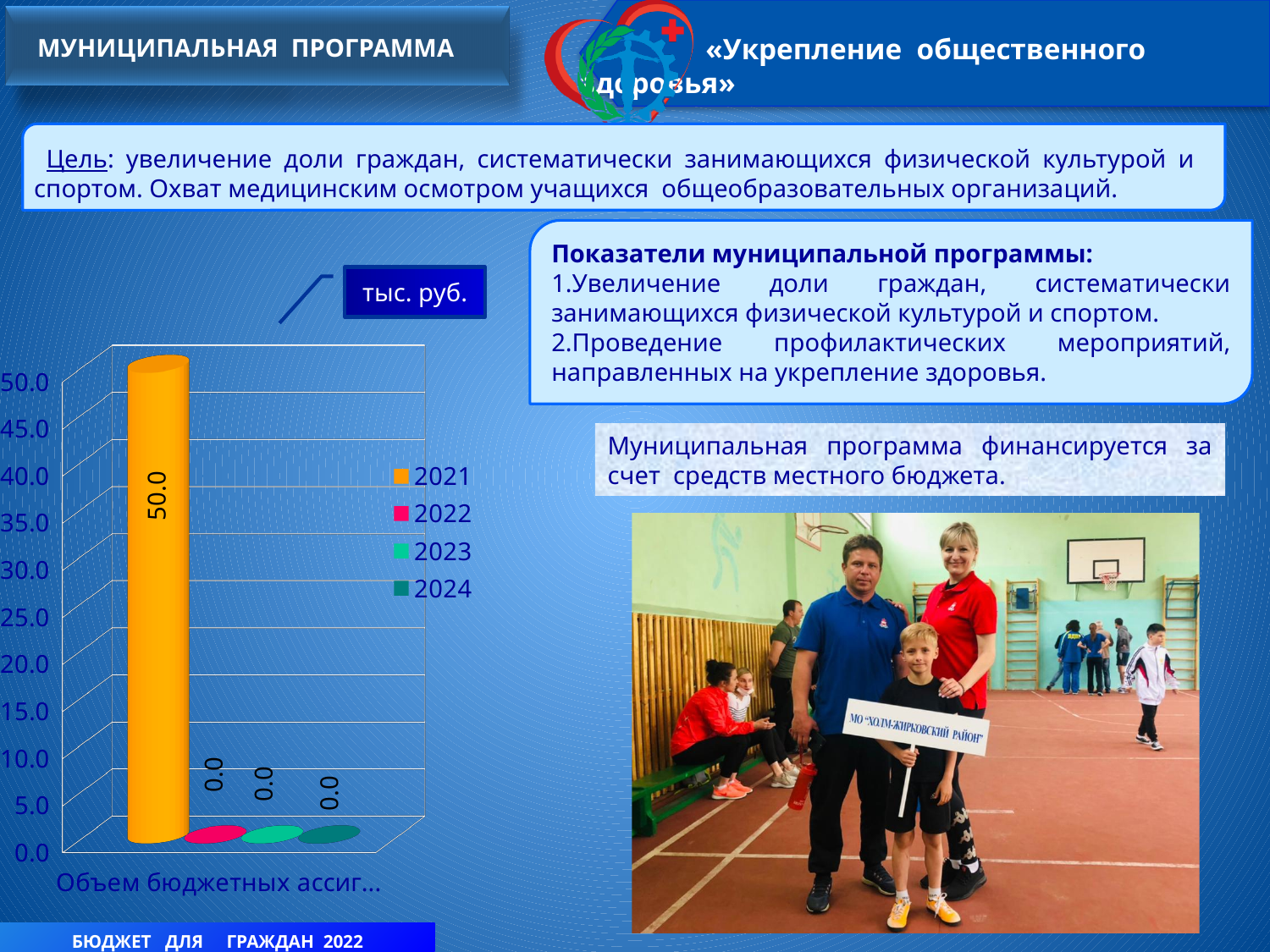
Is the value for 2021 greater or less than 45.0? greater What is the value for 2024 in the chart? 0.0 What is the total of the values for 2021, 2022, 2023 and 2024? 50.0 What is the value for 2021 in the chart? 50.0 What unit is shown in the box above the chart? тыс. руб. What is the value for 2022 in the chart? 0.0 How many series does the chart legend list? 4 What kind of chart is shown on the slide? bar chart Which is larger, the value for 2021 or the value for 2022? 2021 What colour is the bar for 2021 in the chart? orange What is the difference between the values for 2021 and 2023? 50.0 Which year has the highest value in the chart? 2021